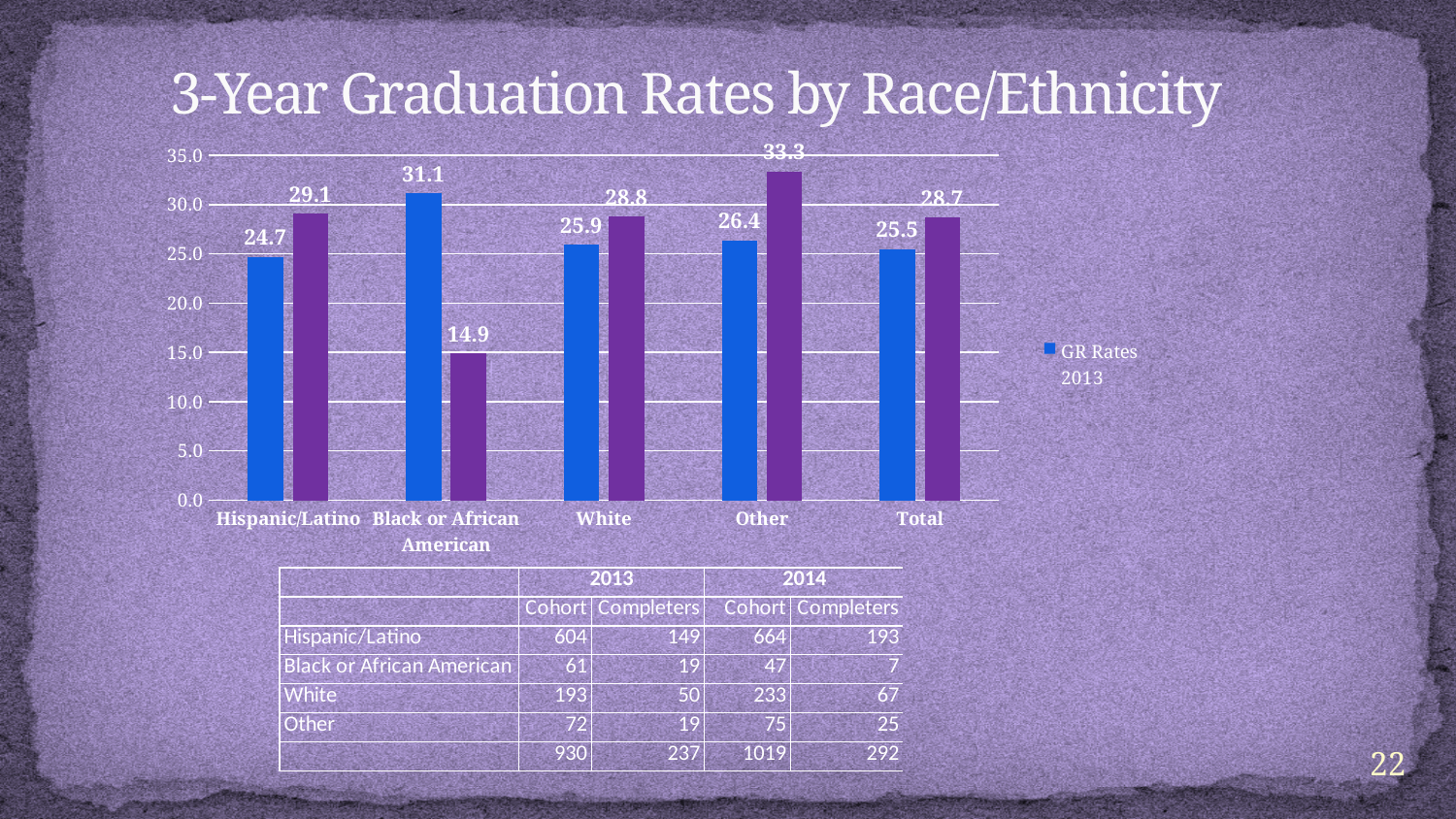
How many categories are shown on the x axis of the chart? 5 What is the GR Rates 2013 value for White? 25.9 For Hispanic/Latino, which is larger: the blue bar or the purple bar? the purple bar Is the purple bar value for Other greater or less than 30.0? greater For the Total category, how much higher is the purple bar than the GR Rates 2013 blue bar? 3.2 Which category has the lowest purple bar value? Black or African American Which category has the highest GR Rates 2013 (blue bar) value? Black or African American What type of chart is shown on the slide? bar chart What is the GR Rates 2013 value for Hispanic/Latino? 24.7 What is the difference between the blue bar (31.1) and the purple bar (14.9) for Black or African American? 16.2 How many series does the chart legend list? 1 What value is labelled on the purple bar for the Other category? 33.3